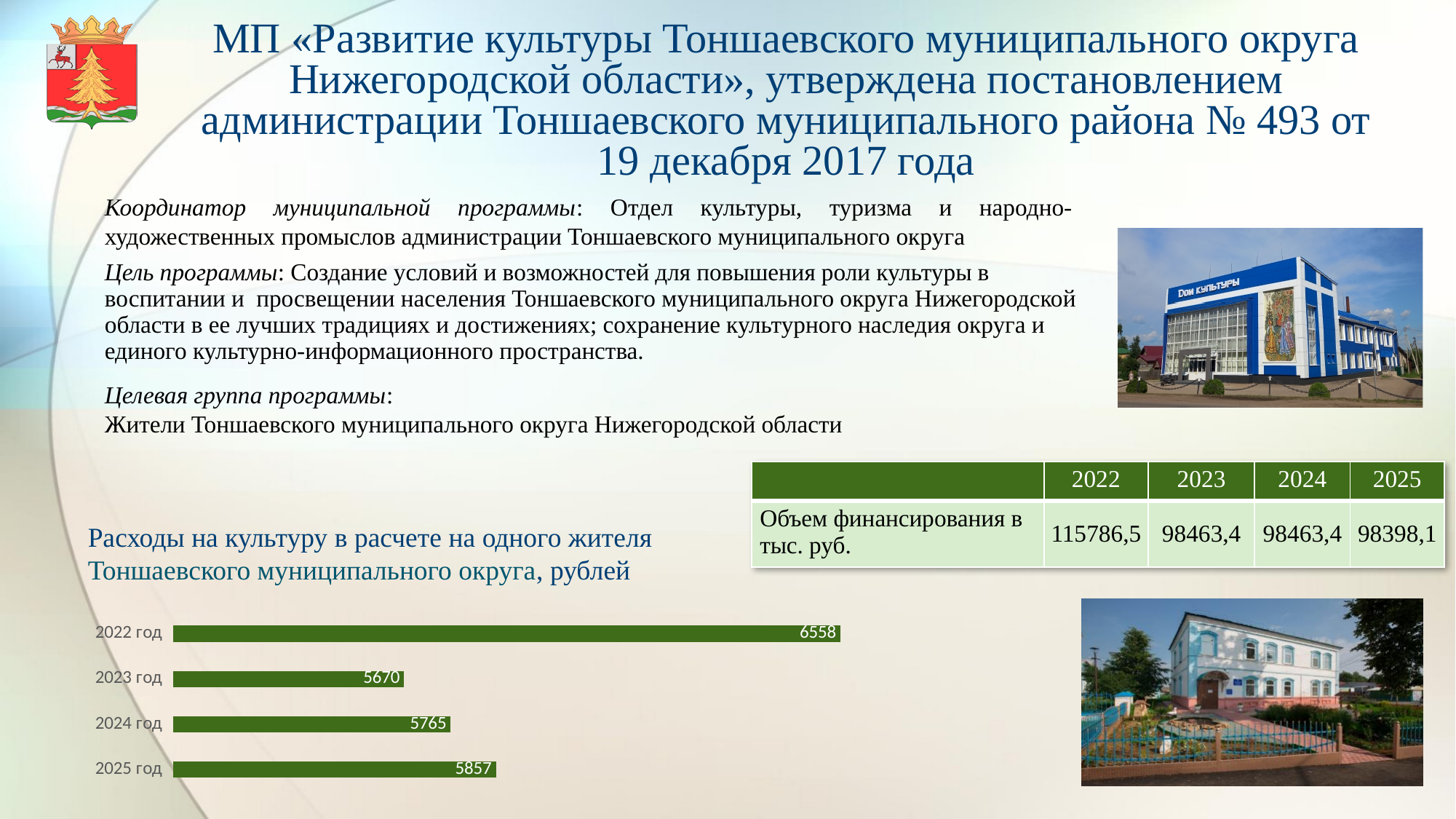
How many years are shown in the bar chart? 4 What is the value for 2022 год in the bar chart? 6558 What is the value for 2024 год in the bar chart? 5765 Which year has the lowest value in the bar chart? 2023 год What is the title of the bar chart? Расходы на культуру в расчете на одного жителя Тоншаевского муниципального округа, рублей What is the value for 2023 год in the bar chart? 5670 What is the difference between the values for 2025 год and 2024 год in the bar chart? 92 Which is larger in the bar chart, the value for 2024 год or 2025 год? 2025 год What is the value for 2025 год in the bar chart? 5857 What is the difference between the values for 2022 год and 2023 год in the bar chart? 888 What kind of chart is shown on the slide? bar chart Which year has the highest value in the bar chart? 2022 год